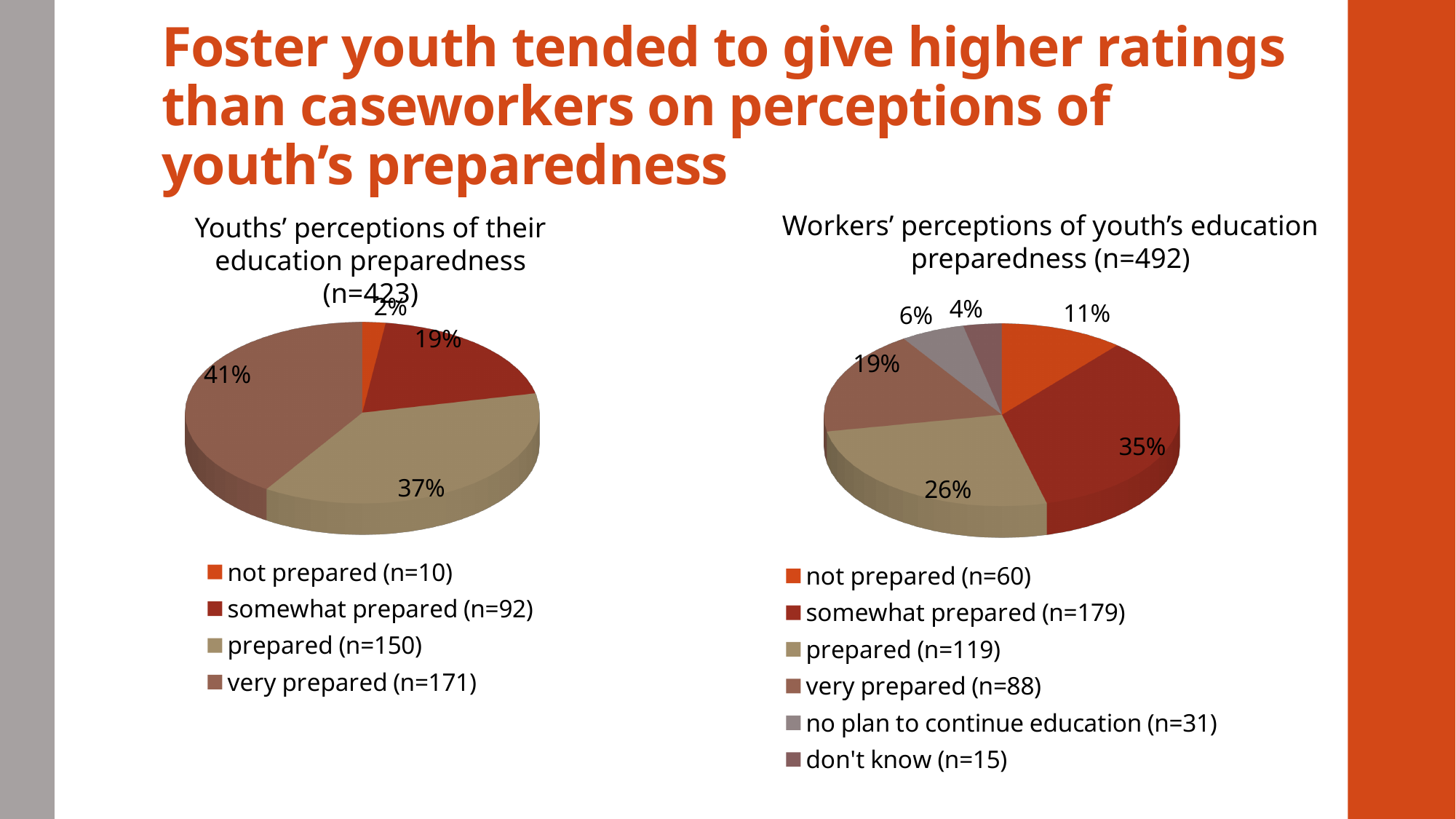
In the 'Youths' perceptions of their education preparedness' chart, what share of the pie is 'very prepared'? 41% In the 'Youths' perceptions of their education preparedness' chart, which category has the smallest slice? not prepared Which is larger: the 'very prepared' share in the youths' chart or the 'very prepared' share in the workers' chart? the youths' chart In the 'Youths' perceptions of their education preparedness' chart, what percentage is shown for 'somewhat prepared'? 19% In the 'Workers' perceptions of youth's education preparedness' chart, what is the difference in percentage points between 'somewhat prepared' and 'prepared'? 9 In the 'Workers' perceptions of youth's education preparedness' chart, how many categories does the legend list? 6 In the 'Youths' perceptions of their education preparedness' chart, how many categories does the legend list? 4 In the 'Workers' perceptions of youth's education preparedness' chart, what share of the pie is 'no plan to continue education'? 6% In the 'Workers' perceptions of youth's education preparedness' chart, which category has the largest slice? somewhat prepared What type of chart is used on this slide? pie chart In the 'Youths' perceptions of their education preparedness' chart, which category has the largest slice? very prepared In the 'Workers' perceptions of youth's education preparedness' chart, what percentage is shown for 'somewhat prepared'? 35%